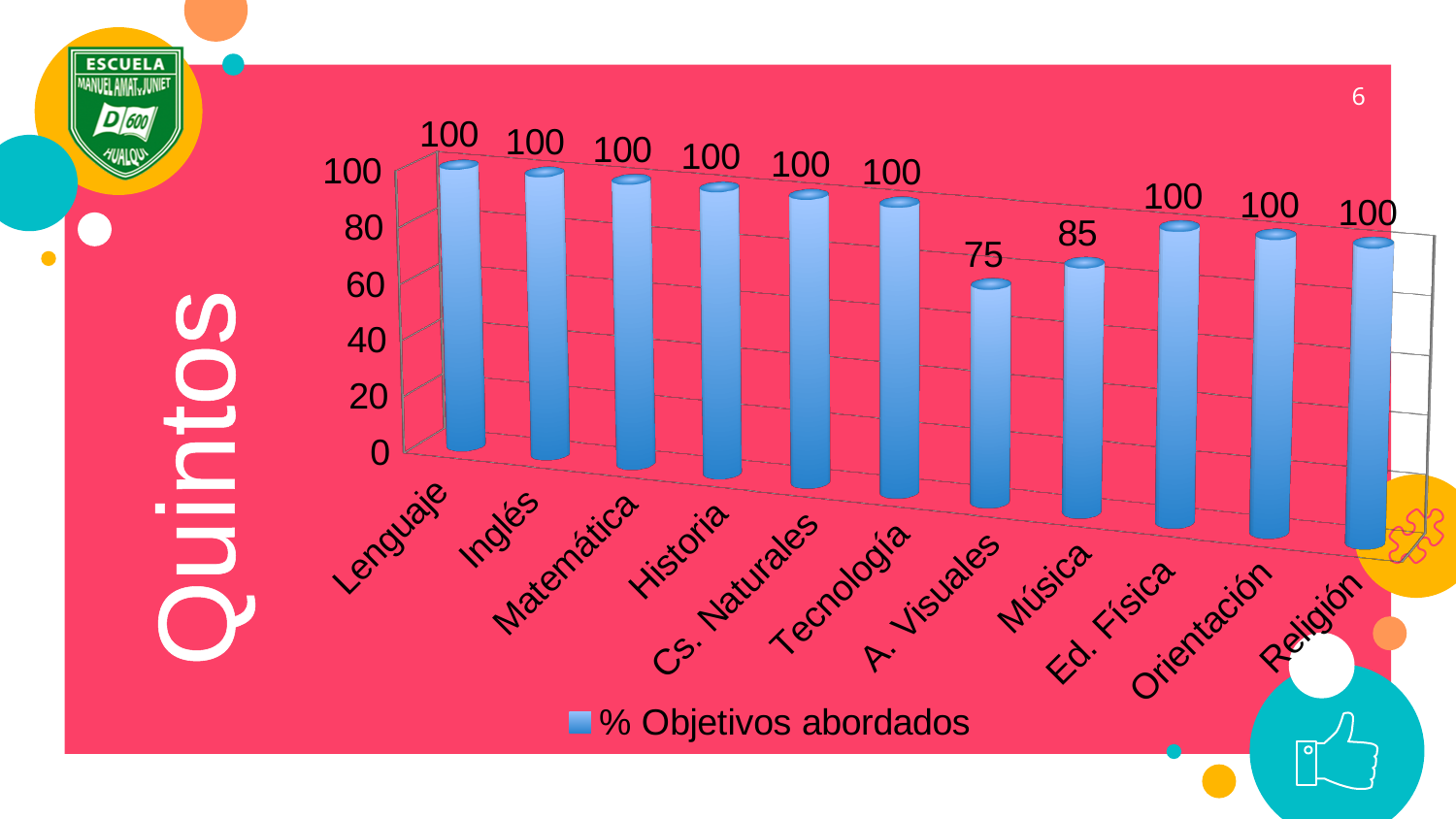
What is the difference between the values for Música and A. Visuales? 10 How many series does the legend list? 1 What is the value for Lenguaje? 100 Which is larger, the value for Música or the value for A. Visuales? Música What is the difference between the values for Historia and A. Visuales? 25 Is the value for A. Visuales greater or less than 80? less What kind of chart is shown on the slide? bar chart How many categories are shown on the x axis? 11 What is the value for Música? 85 Which category has the lowest value? A. Visuales What is the legend entry for the series shown? % Objetivos abordados What is the value for A. Visuales? 75